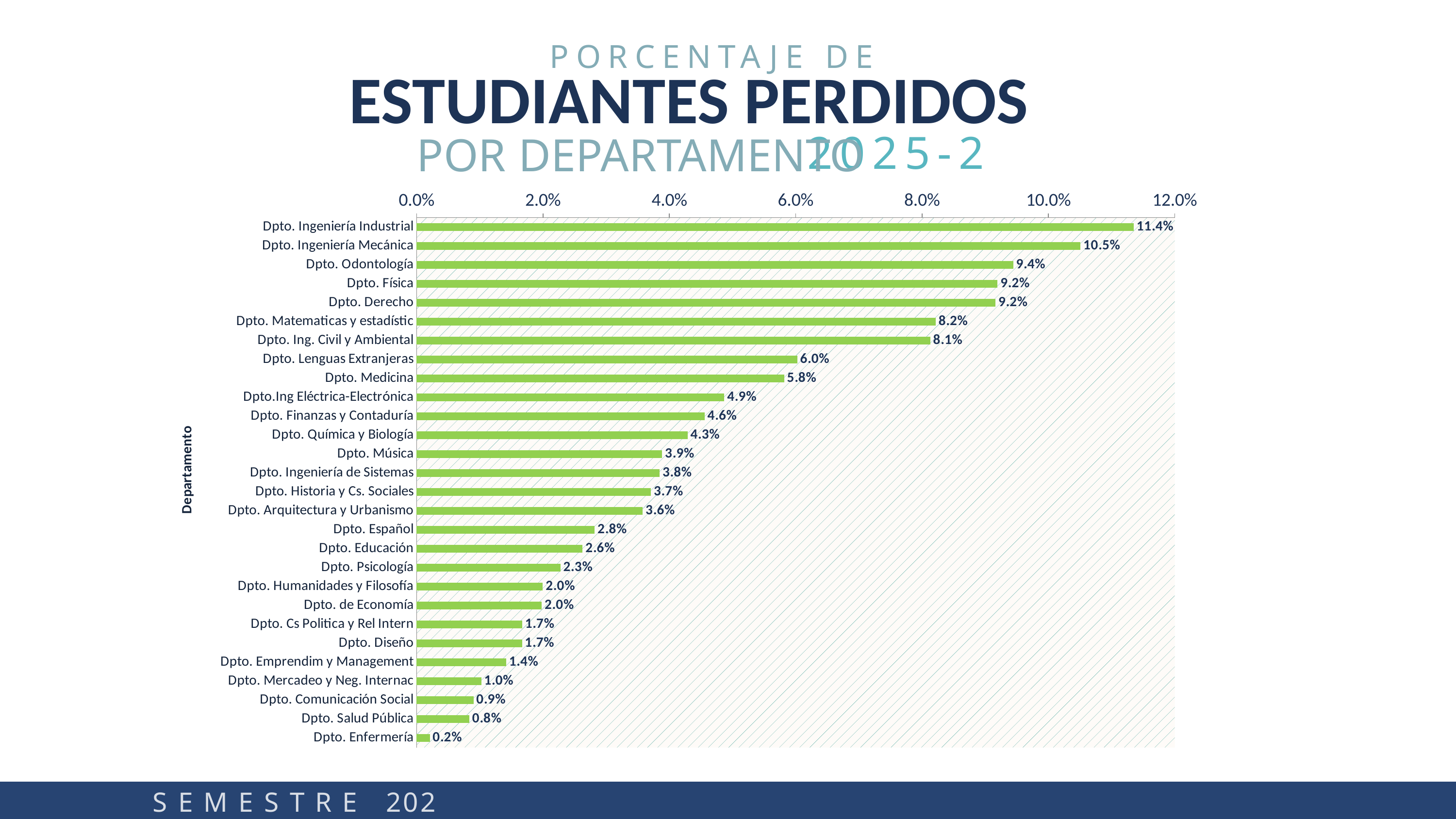
Which department has the lowest percentage? Dpto. Enfermería What is the value for Dpto. Ingeniería Industrial? 11.4% How many departments are shown in the chart? 28 Which department has the highest percentage? Dpto. Ingeniería Industrial Which is larger, the value for Dpto. Odontología or Dpto. Derecho? Dpto. Odontología Is the value for Dpto. Ing. Civil y Ambiental greater or less than 8.0%? greater What is the difference between Dpto. Ingeniería Industrial and Dpto. Ingeniería Mecánica? 0.9% What is the difference between Dpto. Lenguas Extranjeras and Dpto. Español? 3.2% What is the value for Dpto. Medicina? 5.8% What is the value for Dpto. Salud Pública? 0.8% What is the value for Dpto. Psicología? 2.3% What kind of chart is shown on the slide? Bar chart